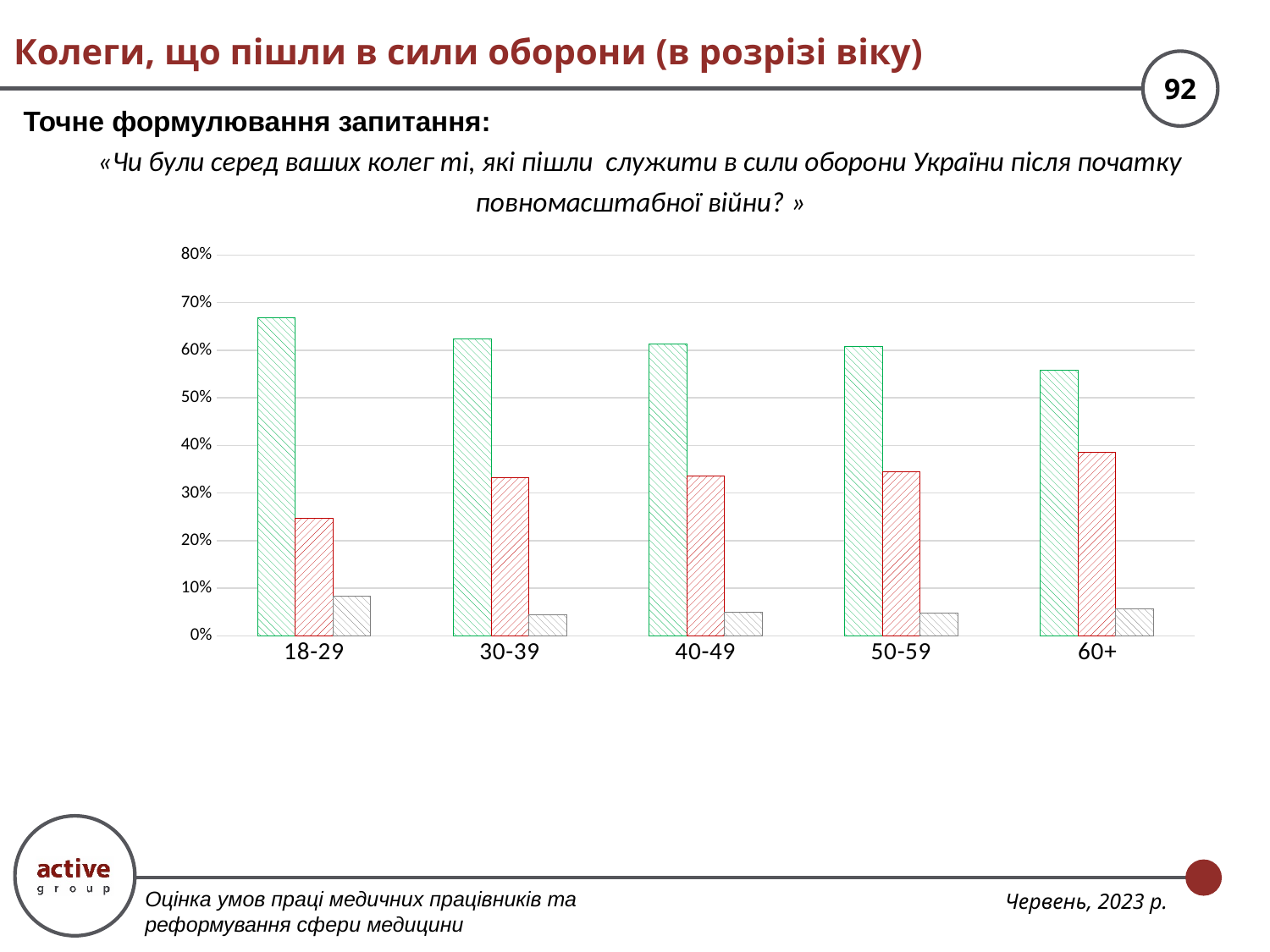
What kind of chart is shown on the slide? bar chart In the 60+ category, which is larger: the green (first) bar or the red (second) bar? the green bar Which age category has the shortest green (first) bar? 60+ How many bars are plotted for each age category in the chart? 3 Is the green (first) bar for 18-29 greater or less than 60%? greater Which age category has the tallest green (first) bar? 18-29 Is the grey (third) bar for 18-29 greater or less than 10%? less Which age category has the shortest red (second) bar? 18-29 Which age category has the tallest red (second) bar? 60+ Do the green (first) bars rise or fall moving from 18-29 to 60+ along the x axis? fall Is the red (second) bar for 18-29 greater or less than 30%? less How many age categories are shown on the x axis of the chart? 5